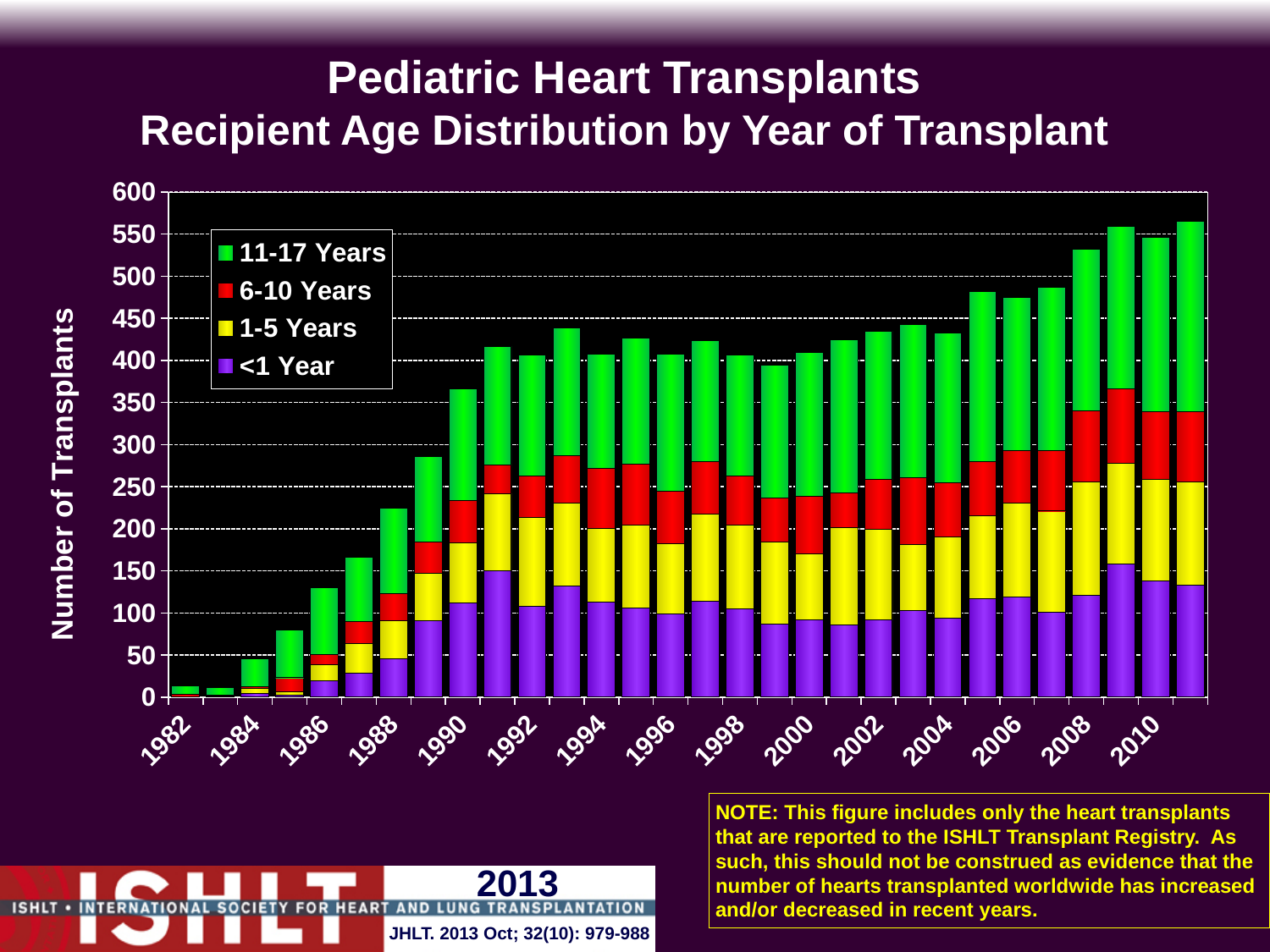
Which year has the larger total number of transplants, 1986 or 1992? 1992 Which year has the larger total number of transplants, 2000 or 2008? 2008 What is the label on the vertical axis? Number of Transplants Is the total number of transplants for 2008 greater or less than 500? greater Is the total number of transplants for 2000 greater or less than 450? less Is the total number of transplants for 1990 greater or less than 350? greater How many yearly bars are plotted in the chart? 30 Do the total numbers of transplants rise or fall from 1982 to 1990? rise How many series does the legend list? 4 What kind of chart is shown on the slide? Stacked bar chart